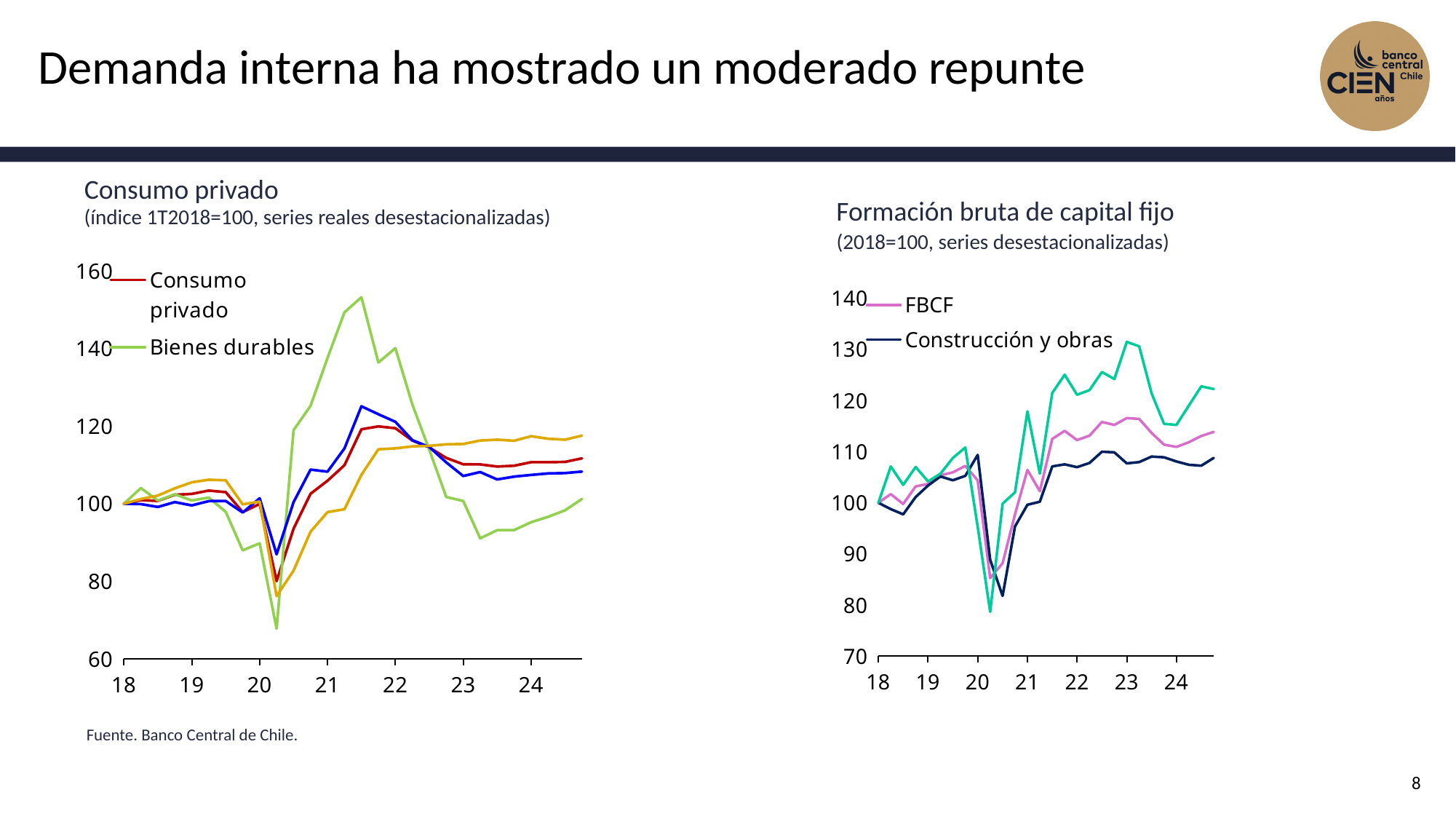
In the 'Formación bruta de capital fijo' chart, is the value of FBCF at the end of 2024 greater or less than 110? greater In the 'Consumo privado' chart, how many series does the legend list? 2 In the 'Formación bruta de capital fijo' chart, how many series does the legend list? 2 In the 'Formación bruta de capital fijo' chart, is the lowest value of Construcción y obras in 2020 greater or less than 90? less In the 'Consumo privado' chart, does Bienes durables rise or fall between its 2021 peak and 2023? fall In the 'Consumo privado' chart, which legend series reaches the highest peak? Bienes durables In the 'Consumo privado' chart, is the value of Consumo privado at the end of 2024 greater or less than 100? greater What kind of chart is the 'Consumo privado' chart on the left? line chart What kind of chart is the 'Formación bruta de capital fijo' chart on the right? line chart What is the title of the chart on the right of the slide? Formación bruta de capital fijo